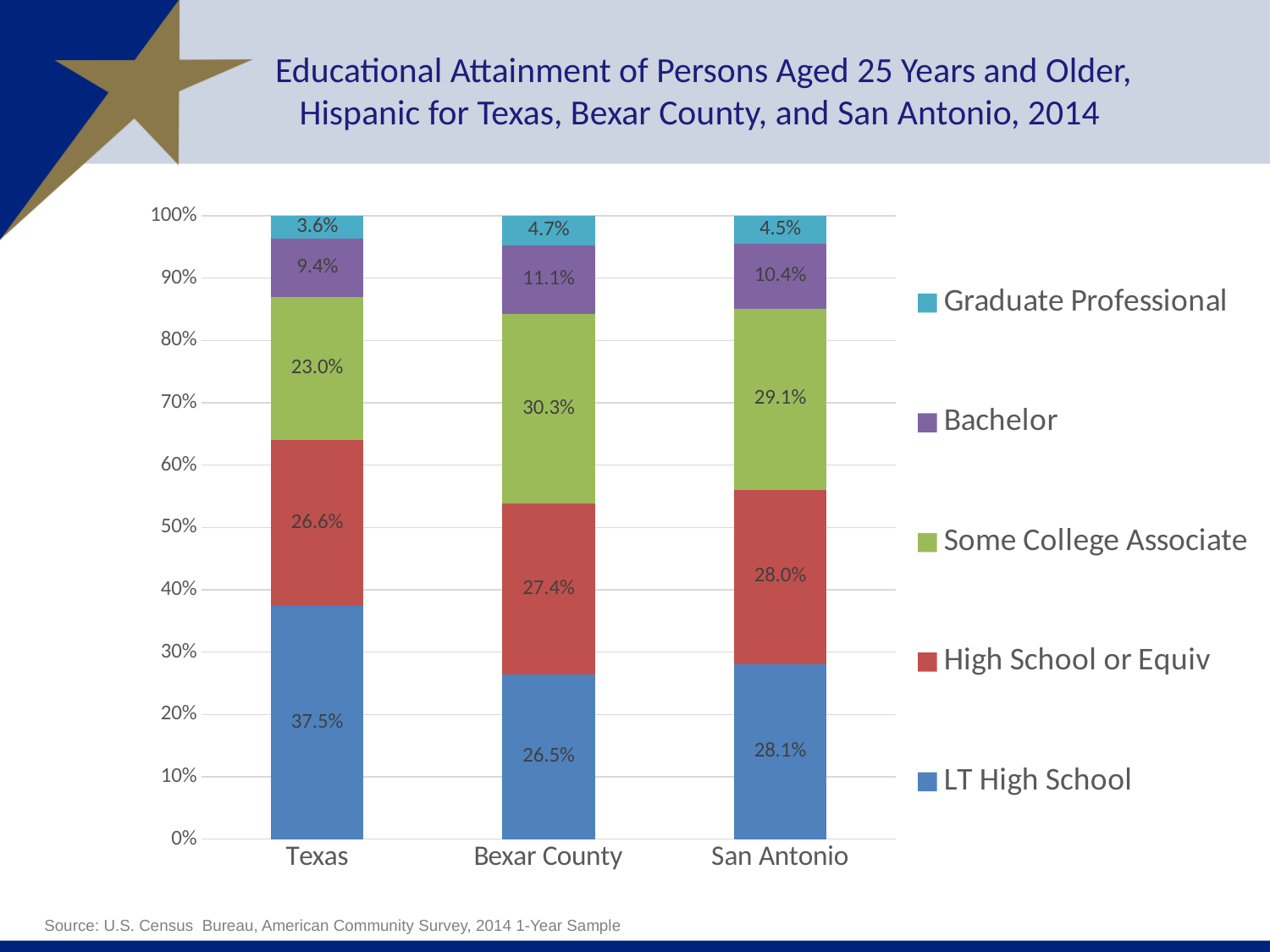
Which series is shown in green in the legend? Some College Associate What kind of chart is shown on the slide? Stacked bar chart Which is larger, the Bachelor value for Bexar County or for San Antonio? Bexar County What is the Bachelor value for Bexar County? 11.1% What is the LT High School value for Texas? 37.5% How many series does the legend list? 5 What is the Some College Associate value for Bexar County? 30.3% Which category has the lowest Some College Associate value? Texas How many categories are shown on the x axis? 3 Which category has the highest LT High School value? Texas What is the Graduate Professional value for San Antonio? 4.5% What is the difference between the LT High School values for Texas and Bexar County? 11.0%